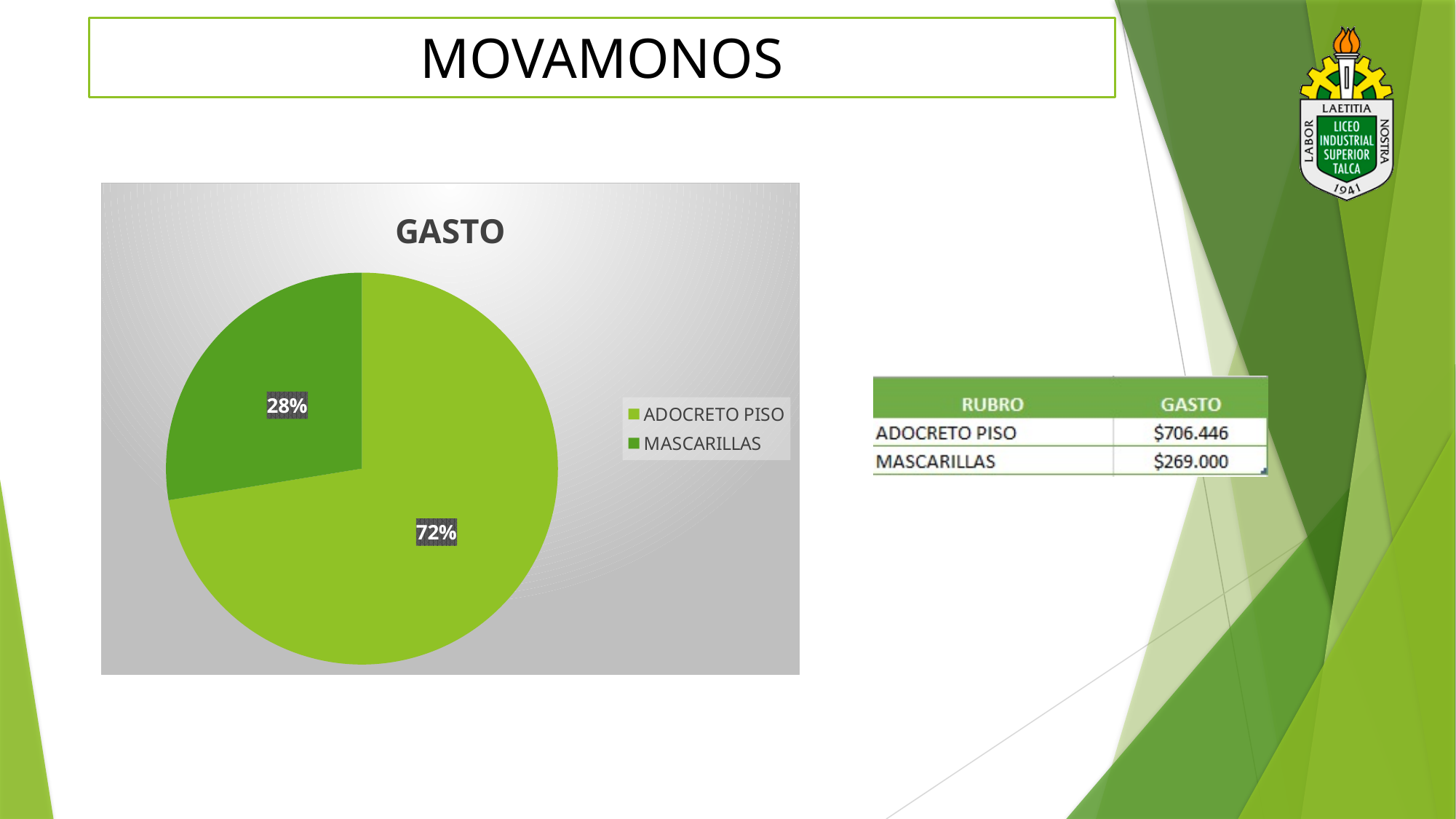
What share of the GASTO pie does ADOCRETO PISO represent? 72% Which category has the largest slice in the GASTO pie chart? ADOCRETO PISO What kind of chart is shown under the title GASTO? Pie chart Which slice is larger in the GASTO pie chart, ADOCRETO PISO or MASCARILLAS? ADOCRETO PISO How many entries does the legend of the GASTO pie chart list? 2 What share of the GASTO pie does MASCARILLAS represent? 28% What is the title of the pie chart on the slide? GASTO Which legend entry in the GASTO pie chart is shown in the darker green? MASCARILLAS What is the difference in percentage points between the ADOCRETO PISO and MASCARILLAS slices in the GASTO pie chart? 44 percentage points Which category has the smallest slice in the GASTO pie chart? MASCARILLAS How many slices does the GASTO pie chart have? 2